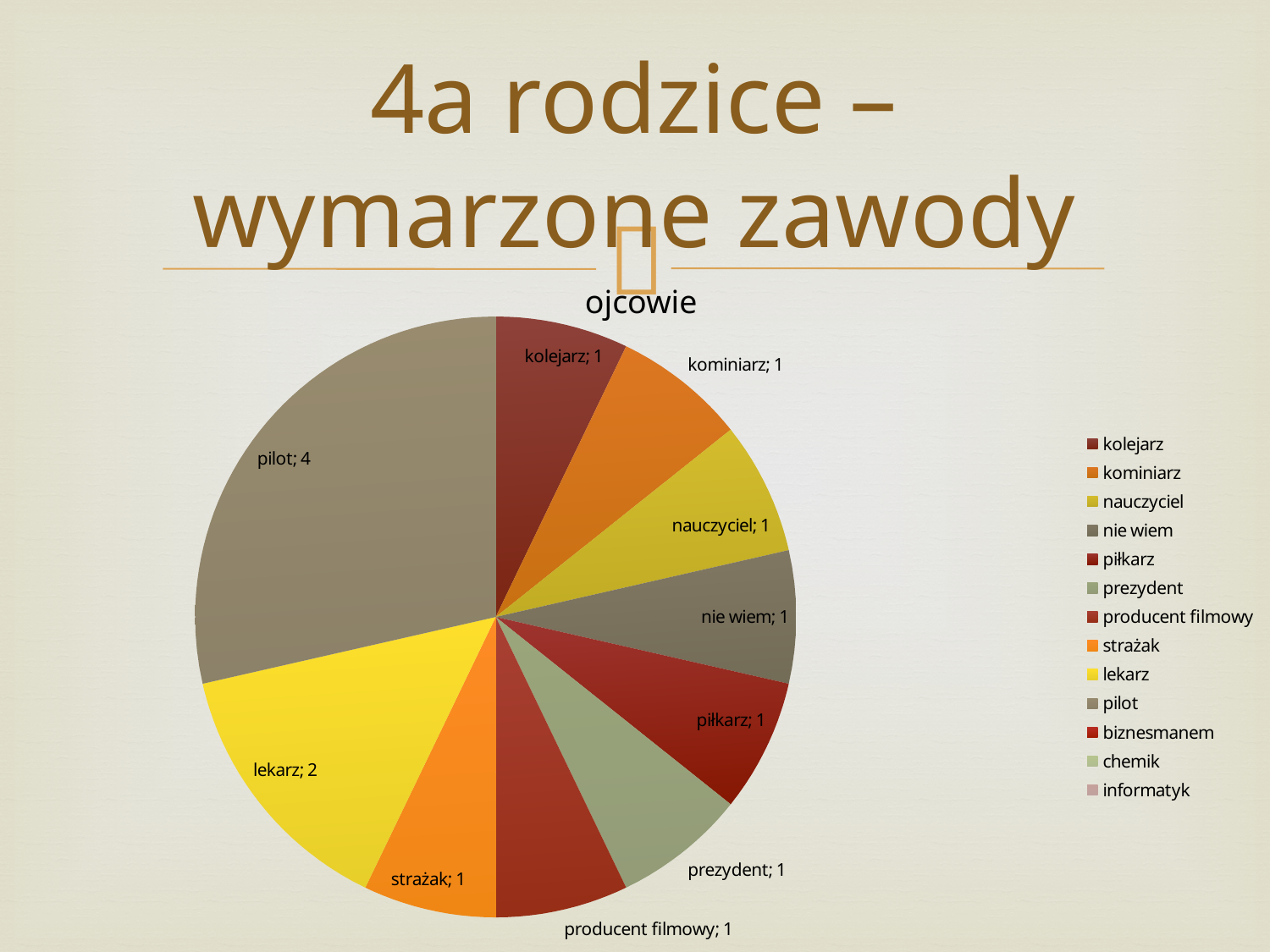
What is the value for strażak? 1 How many entries does the legend list? 13 What is the value for nie wiem? 1 What kind of chart is shown on the slide? pie chart What is the title of the chart? ojcowie Which category has the largest slice? pilot What is the value for pilot? 4 What is the value for lekarz? 2 What is the difference between the values for pilot and nauczyciel? 3 What is the difference between the values for pilot and lekarz? 2 Which is larger, the value for lekarz or the value for kominiarz? lekarz How many slices with data labels does the pie chart have? 10